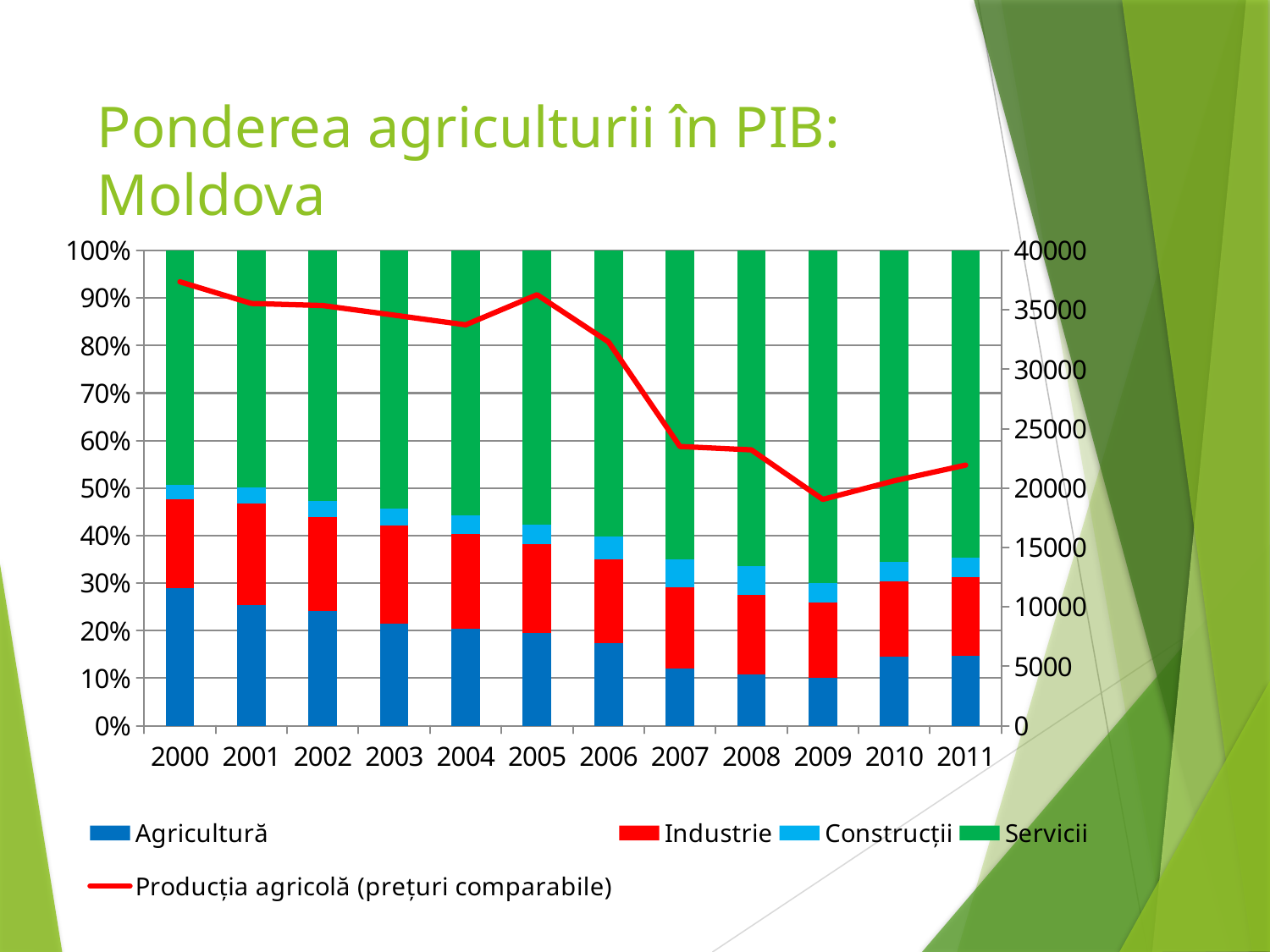
Which year has the larger Agricultură share, 2000 or 2011? 2000 In which year is the Agricultură share of the bar the highest? 2000 How many years are shown on the x axis? 12 In which year is the Producția agricolă line at its lowest? 2009 Is the Agricultură share in 2008 greater or less than 20%? less Does the Producția agricolă line generally rise or fall from 2000 to 2009? fall What kind of chart is shown on the slide? Stacked bar chart with a line What is the title of the chart on the slide? Ponderea agriculturii în PIB: Moldova Which series is plotted as a line? Producția agricolă (prețuri comparabile) Is the Agricultură share in 2000 greater or less than 20%? greater Is the Producția agricolă value in 2007 greater or less than 25000? less How many series does the legend list? 5